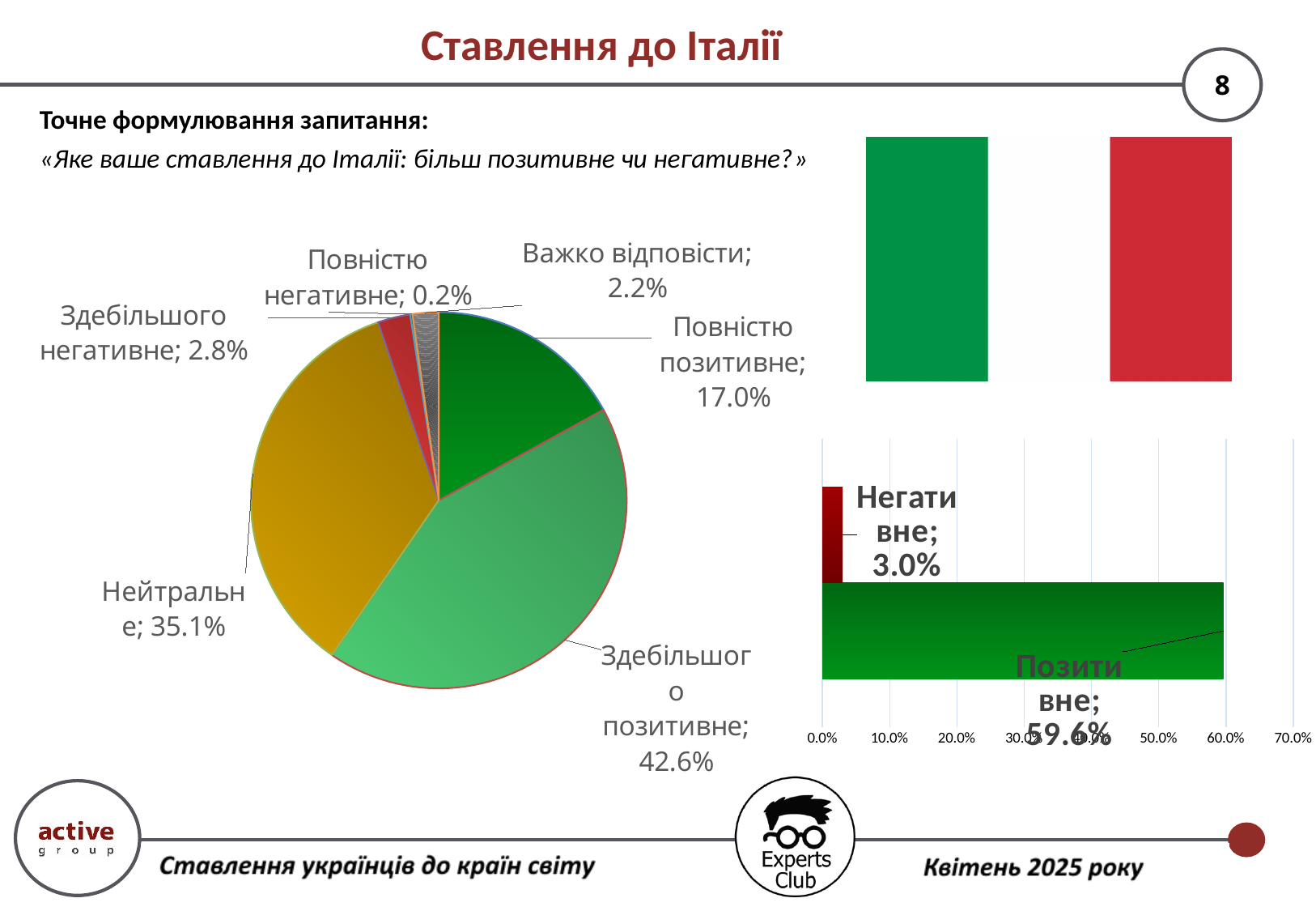
What type of chart is shown at the bottom right of the slide? Bar chart On the bar chart at the bottom right, what is the value for «Негативне»? 3.0% On the pie chart, what share of respondents answered «Важко відповісти»? 2.2% On the pie chart, which category has the smallest share? Повністю негативне On the pie chart, what is the difference between «Здебільшого позитивне» and «Нейтральне»? 7.5% On the pie chart, what share of respondents answered «Повністю позитивне»? 17.0% On the pie chart, how many slices (categories) are shown? 6 On the bar chart at the bottom right, what is the value for «Позитивне»? 59.6% On the pie chart, which is larger: «Здебільшого негативне» or «Важко відповісти»? Здебільшого негативне On the pie chart, what share of respondents answered «Здебільшого позитивне»? 42.6% On the pie chart, what share of respondents answered «Нейтральне»? 35.1% On the pie chart, which category has the largest share? Здебільшого позитивне